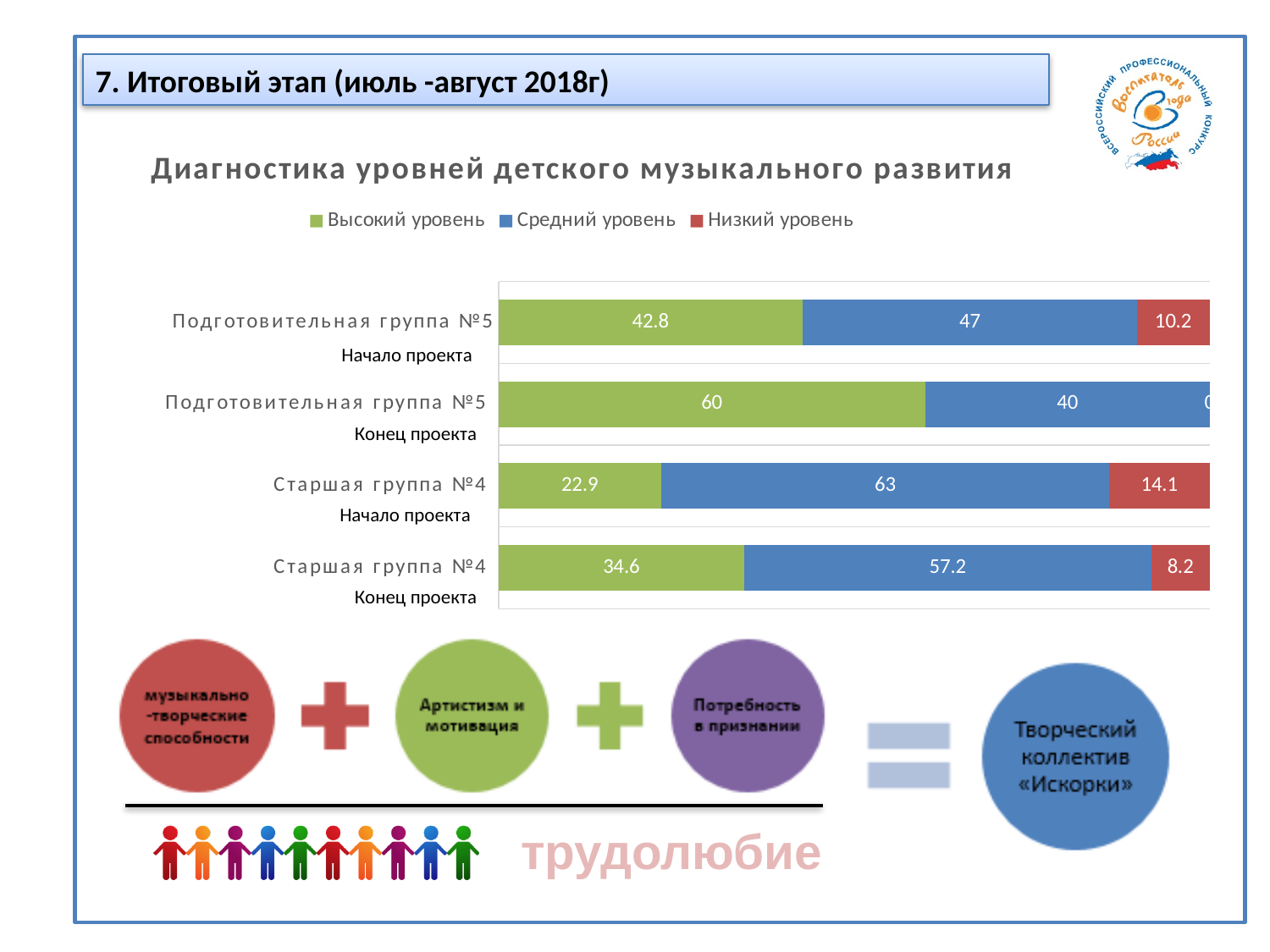
Which category has the highest value for Высокий уровень? Подготовительная группа №5, Конец проекта How many series does the chart legend list? 3 What is the value of Высокий уровень for Подготовительная группа №5, Начало проекта? 42.8 How many categories (bars) are plotted in the chart? 4 What is the value of Высокий уровень for Подготовительная группа №5, Конец проекта? 60 What is the value of Низкий уровень for Старшая группа №4, Конец проекта? 8.2 What kind of chart is shown on the slide? Stacked bar chart What is the value of Средний уровень for Старшая группа №4, Начало проекта? 63 Which category has the lowest value for Высокий уровень? Старшая группа №4, Начало проекта Which is larger: the Низкий уровень value for Старшая группа №4, Начало проекта or for Подготовительная группа №5, Начало проекта? Старшая группа №4, Начало проекта What is the difference between the Высокий уровень values for Старшая группа №4 at the end of the project (Конец проекта) and at the start (Начало проекта)? 11.7 What is the title of the chart? Диагностика уровней детского музыкального развития